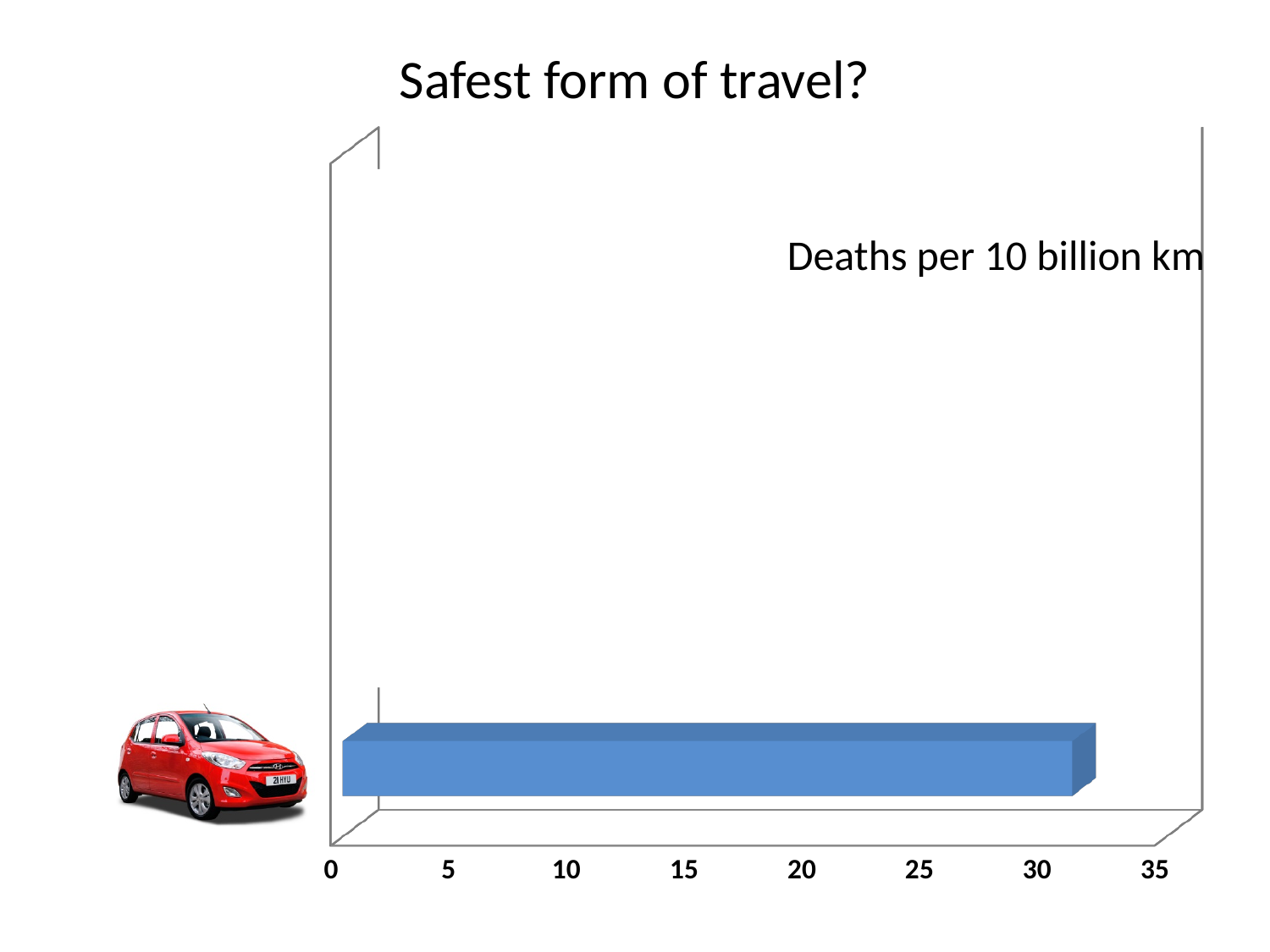
How many bars are plotted in the chart? 1 What kind of chart is shown on the slide? bar chart What measure does the chart say the values represent? Deaths per 10 billion km What is the highest value shown on the horizontal axis? 35 Is the value of the bar for the car greater or less than 35? less Is the value of the bar for the car greater or less than 25? greater Is the value of the bar for the car greater or less than 20? greater What is the title of the chart? Safest form of travel?